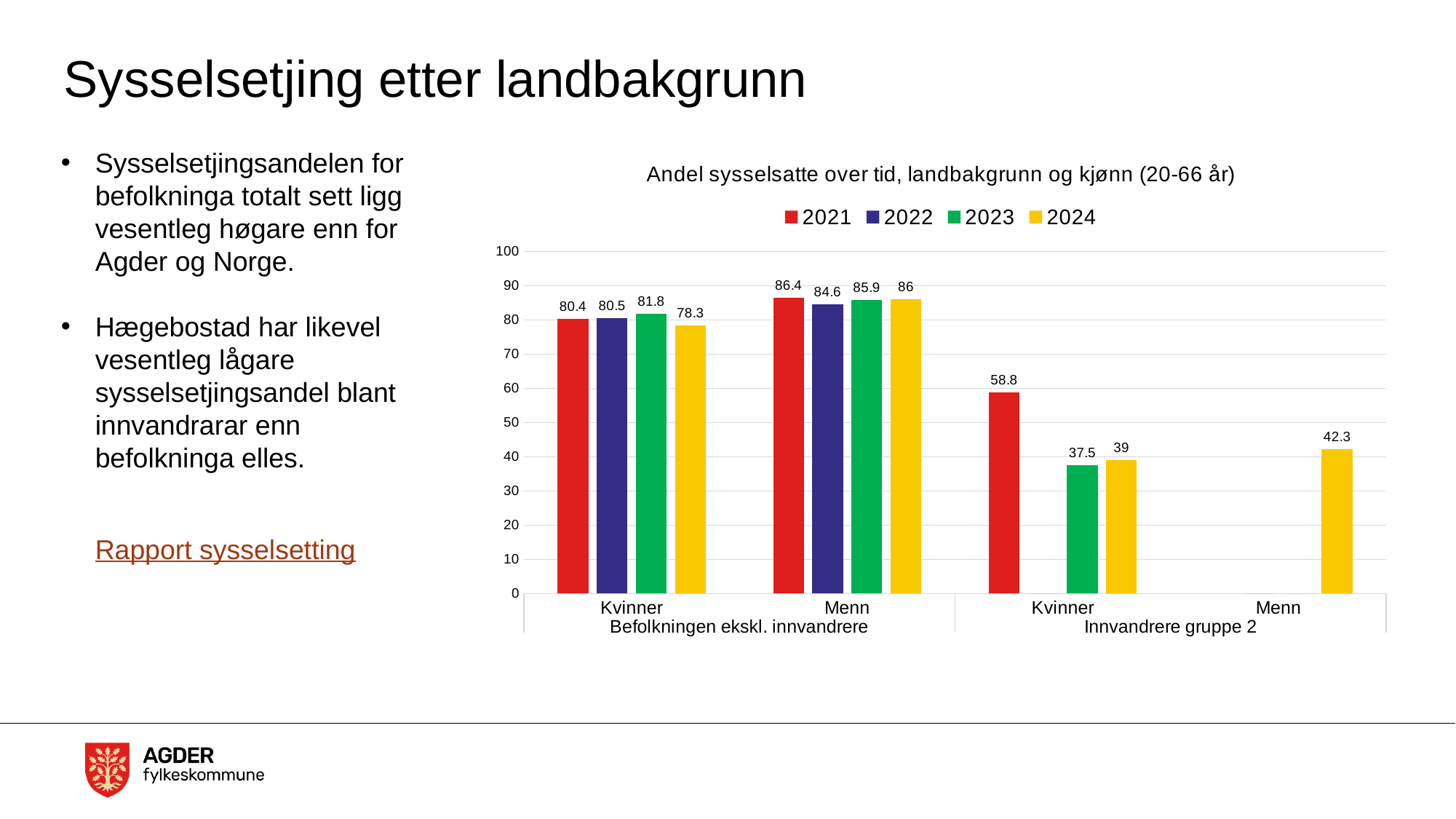
What is the 2024 value for Menn in Befolkningen ekskl. innvandrere? 86 Which year has the highest value for Menn in Befolkningen ekskl. innvandrere? 2021 How many series does the legend list? 4 What kind of chart is shown on the slide? Bar chart What is the 2021 value for Kvinner in Befolkningen ekskl. innvandrere? 80.4 Which is larger: the 2023 value for Kvinner in Befolkningen ekskl. innvandrere or the 2023 value for Menn in Befolkningen ekskl. innvandrere? Menn Is the 2021 value for Kvinner in Innvandrere gruppe 2 greater or less than 50? greater What is the 2023 value for Kvinner in Innvandrere gruppe 2? 37.5 Which year has the lowest value for Kvinner in Befolkningen ekskl. innvandrere? 2024 What is the title of the chart? Andel sysselsatte over tid, landbakgrunn og kjønn (20-66 år) What is the difference between the 2021 and 2024 values for Kvinner in Innvandrere gruppe 2? 19.8 What is the 2024 value for Menn in Innvandrere gruppe 2? 42.3